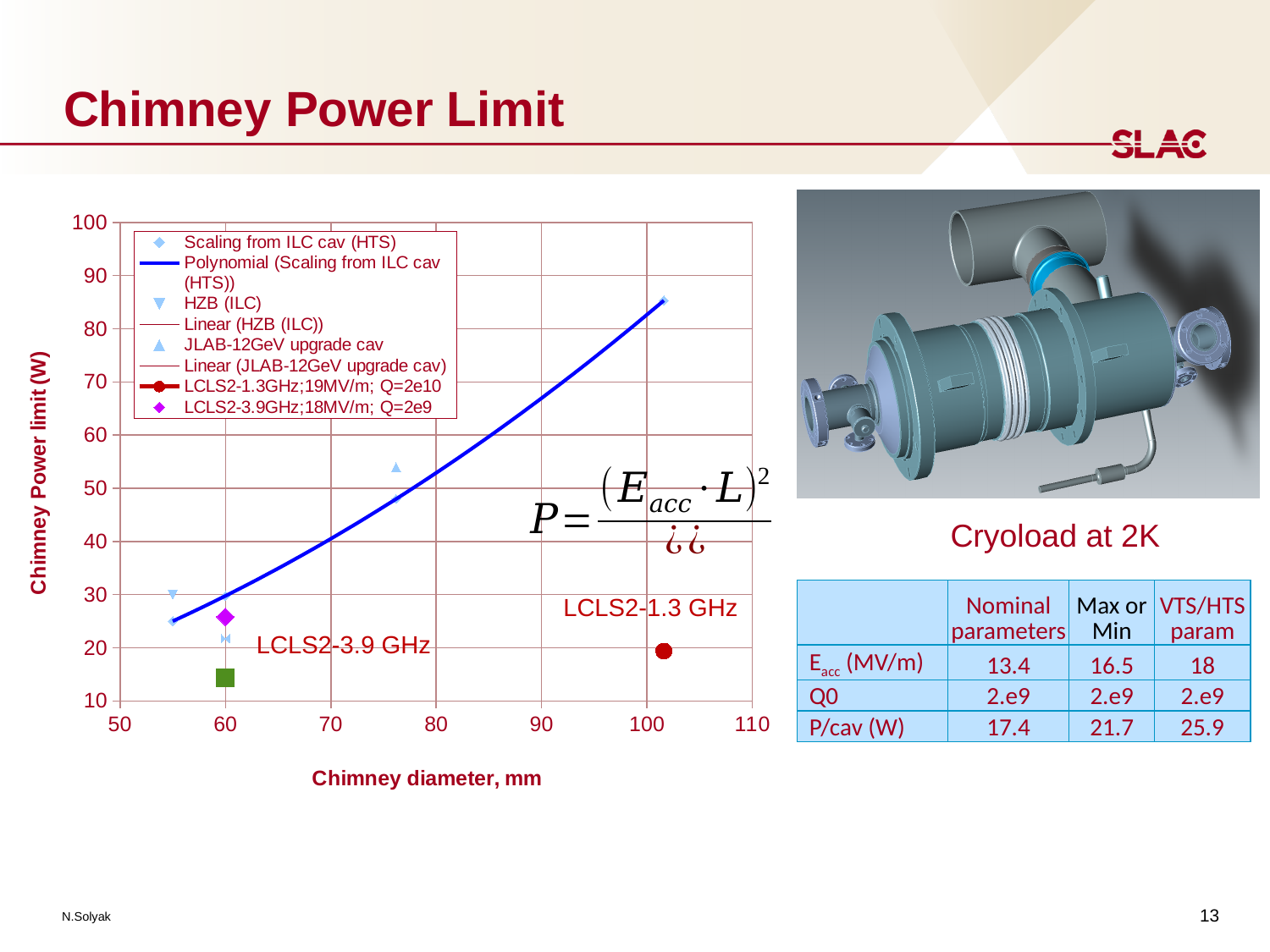
Is the chimney power limit for the LCLS2-1.3 GHz point greater or less than 30 W? less Which has the higher chimney power limit, the JLAB-12GeV upgrade cav point or the LCLS2-1.3 GHz point? JLAB-12GeV upgrade cav What kind of chart is shown on the slide? scatter chart Does the polynomial trend line rise or fall as chimney diameter increases? rises What is the label of the y axis of the chart? Chimney Power limit (W) Is the chimney power limit for the JLAB-12GeV upgrade cav point greater or less than 50 W? greater Is the chimney diameter of the LCLS2-1.3 GHz point greater or less than 90 mm? greater How many entries does the chart legend list? 8 What is the label of the x axis of the chart? Chimney diameter, mm Which has the higher chimney power limit, the LCLS2-3.9 GHz point or the LCLS2-1.3 GHz point? LCLS2-3.9 GHz